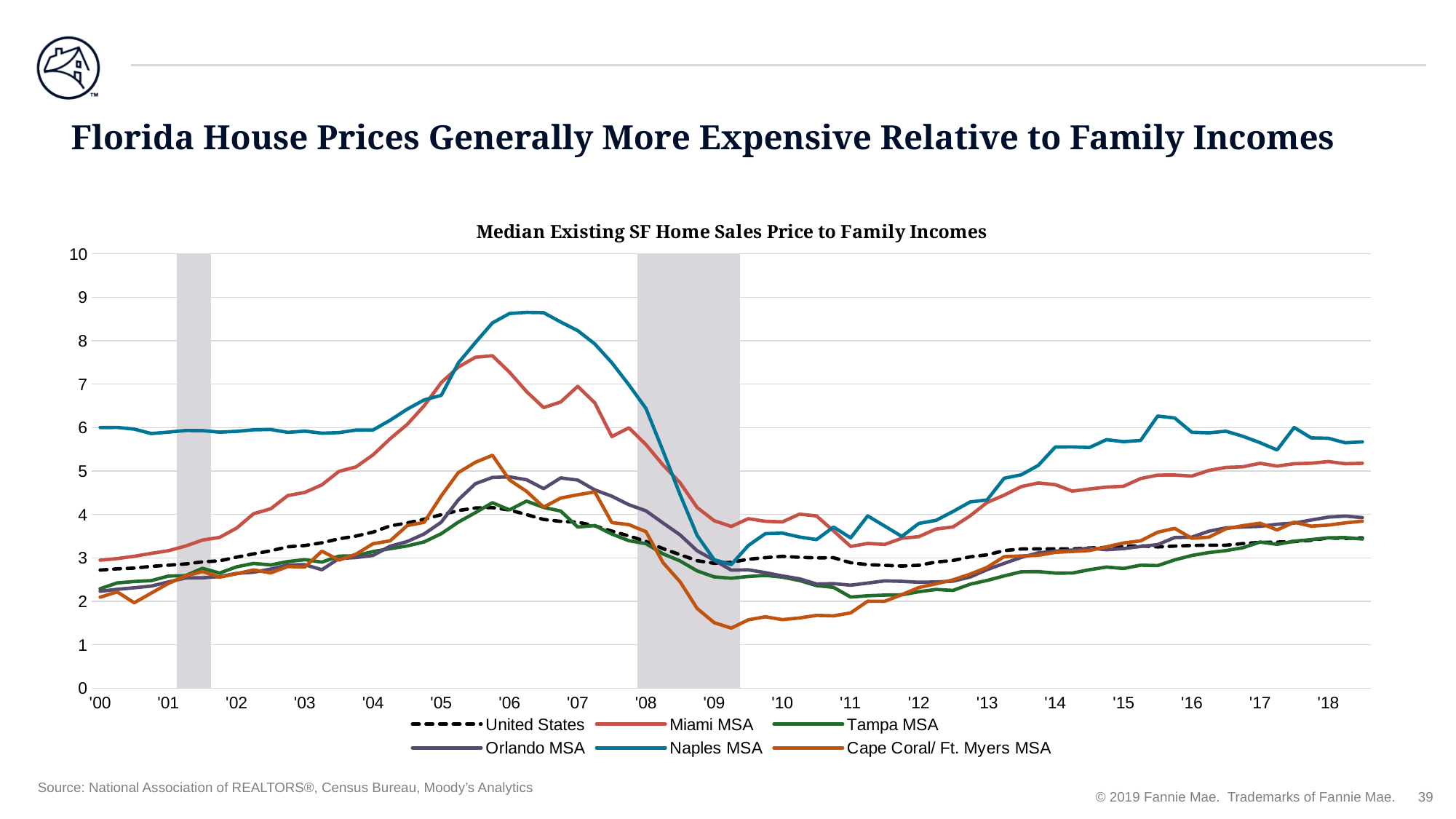
Does the Miami MSA line rise or fall from '07 to '09? fall Which series is drawn as a dashed line? United States Which series reaches the highest value anywhere on the chart? Naples MSA Is the peak value for Naples MSA around '06 greater or less than 8? greater Which series has the lowest value in '09? Cape Coral/ Ft. Myers MSA Is the value for Cape Coral/ Ft. Myers MSA in '09 greater or less than 2? less Does the Naples MSA line rise or fall from '04 to '06? rise What kind of chart is shown on the slide? line chart What is the title of the chart? Median Existing SF Home Sales Price to Family Incomes In '18, which is higher, Naples MSA or Miami MSA? Naples MSA How many series does the legend list? 6 Is the value for United States in '00 greater or less than 3? less